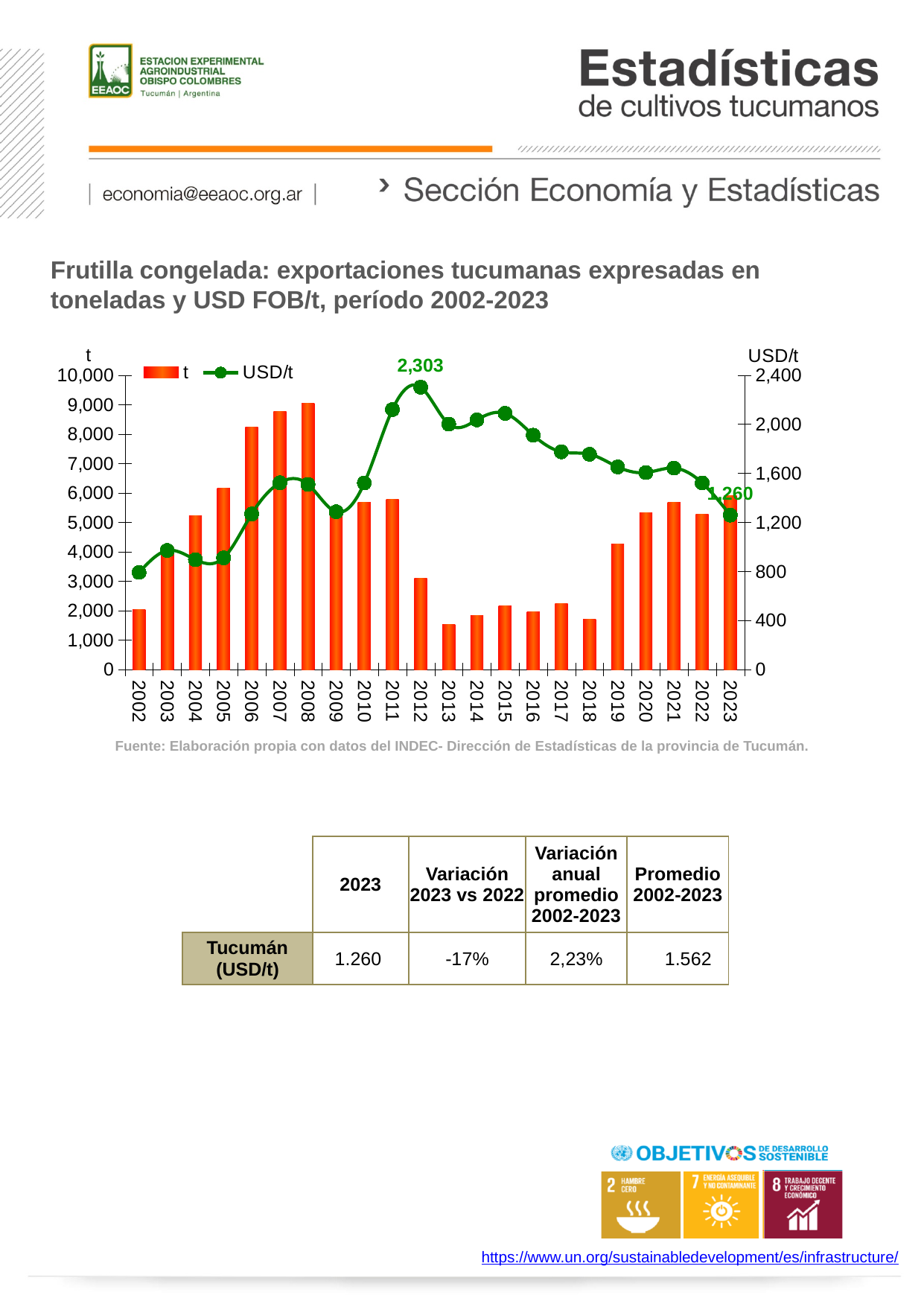
How many series does the chart legend list? 2 What is the USD/t value shown for 2023? 1,260 What is the USD/t value shown for 2012? 2,303 In which year does the USD/t line reach its highest value? 2012 Does the USD/t line rise or fall from 2012 to 2023? fall What kind of chart is shown on the slide? Combined bar and line chart What is the difference between the USD/t value in 2012 and in 2023? 1,043 Is the tonnes value for 2002 greater or less than 3,000? less Is the tonnes value for 2006 greater or less than 8,000? greater Is the tonnes value for 2013 greater or less than 2,000? less Which year has the larger tonnes bar, 2008 or 2012? 2008 How many years are shown on the x axis of the chart? 22